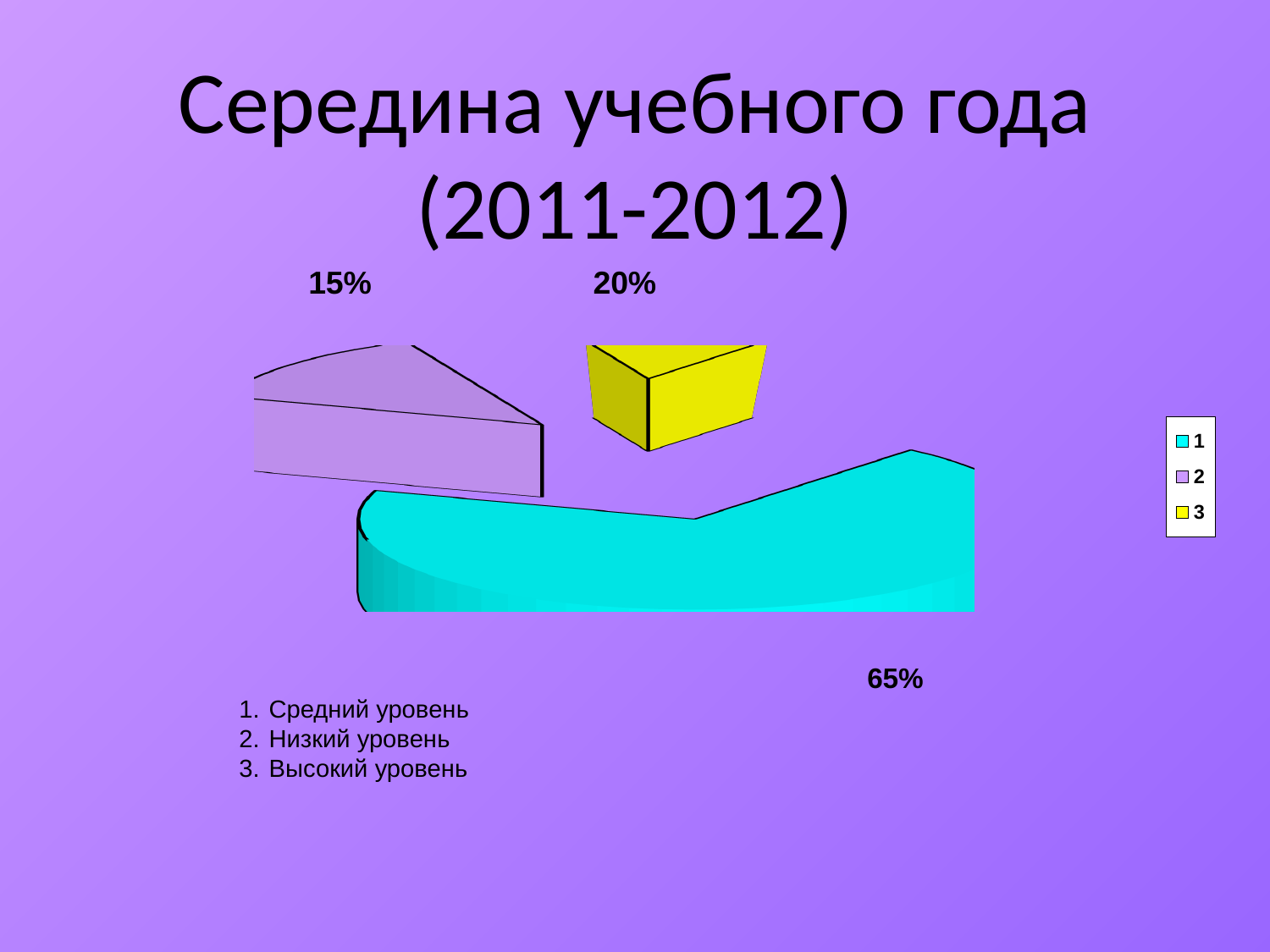
What share of the pie does slice 2 (Низкий уровень) have? 15% What colour is the slice for category 3 in the legend? yellow Which slice of the pie is the smallest? 2 (Низкий уровень) Which slice of the pie is the largest? 1 (Средний уровень) How many slices does the pie chart have? 3 What share of the pie does slice 1 (Средний уровень) have? 65% What kind of chart is shown on the slide? pie chart What is the difference between the share of slice 1 and the share of slice 3? 45% How many entries does the legend list? 3 What share of the pie does slice 3 (Высокий уровень) have? 20% What is the difference between the share of slice 3 and the share of slice 2? 5% Which is larger, the share of slice 2 or the share of slice 3? slice 3